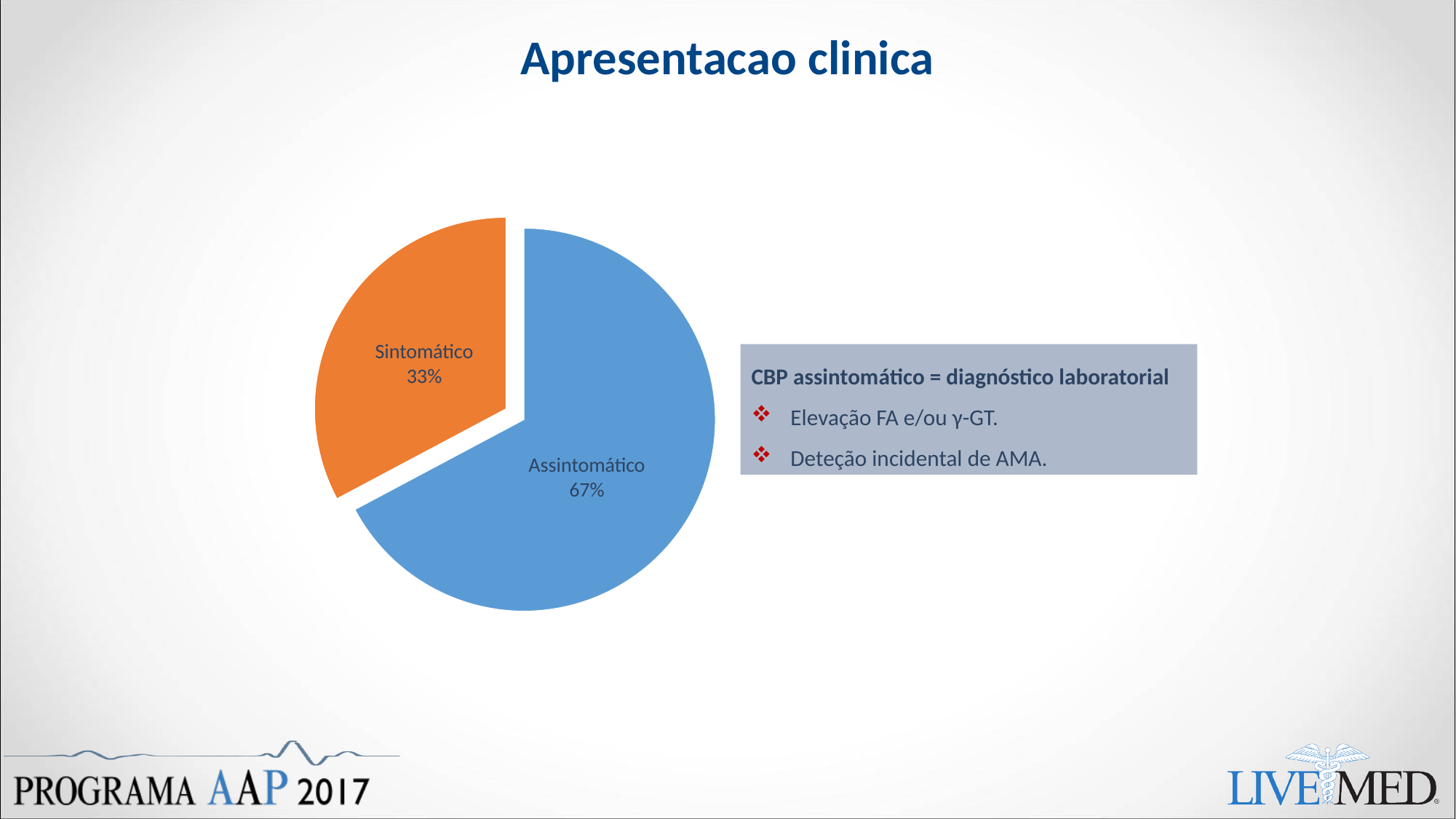
What is the difference in percentage points between the Assintomático and Sintomático slices? 34 Which is larger, the Sintomático slice or the Assintomático slice? Assintomático What colour is the Assintomático slice? blue What colour is the Sintomático slice? orange Which slice of the pie is the smallest? Sintomático How many slices does the pie chart have? 2 What share of the pie does the Sintomático slice represent? 33% What kind of chart is shown on the slide? pie chart What percentage of the pie is labelled Sintomático? 33% What percentage of the pie is labelled Assintomático? 67% Which slice of the pie is the largest? Assintomático